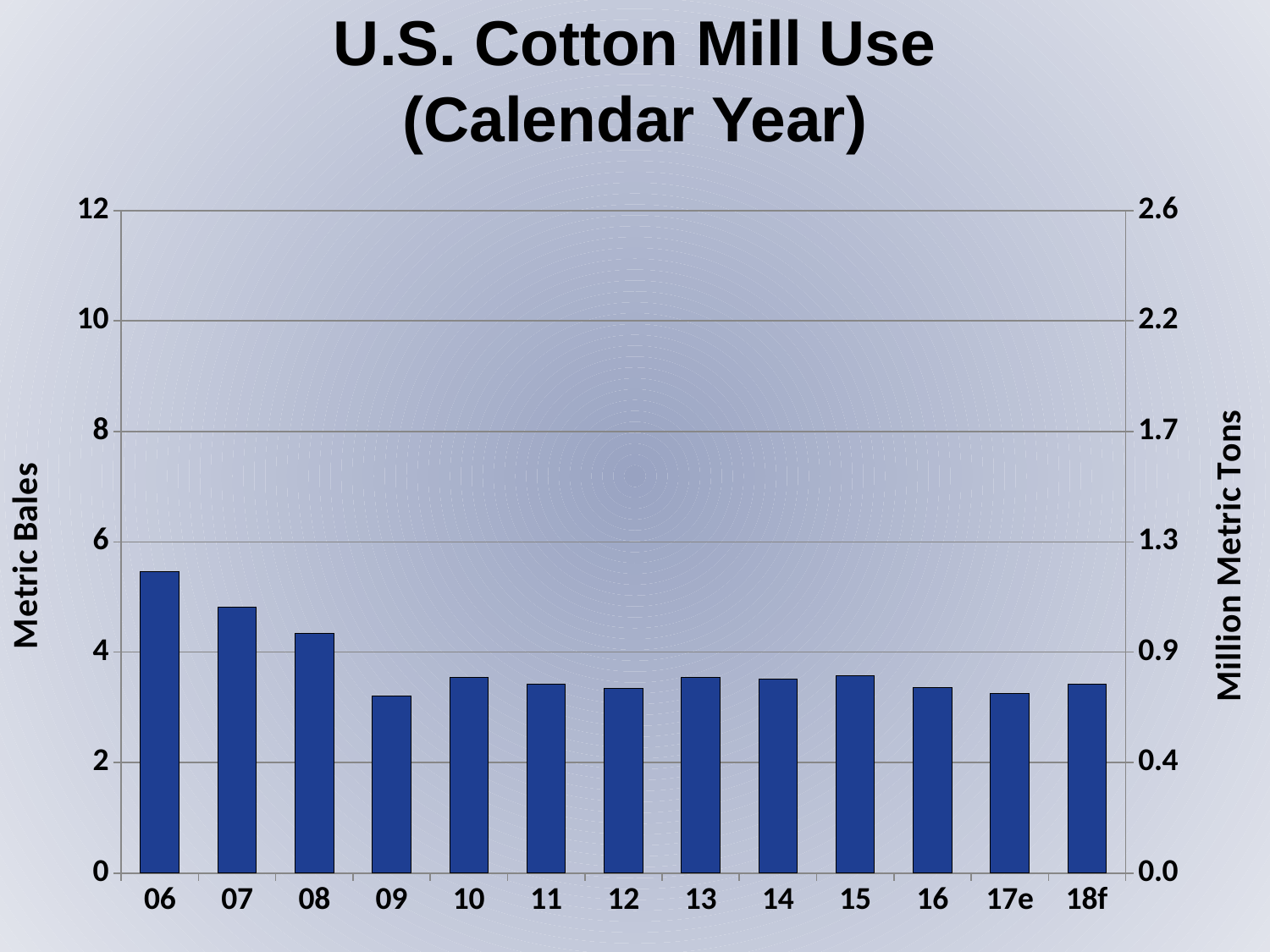
What is the title of the right vertical axis? Million Metric Tons Is the value for 06 greater or less than 4 metric bales? greater What kind of chart is shown on the slide? bar chart Is the value for 06 greater or less than 6 metric bales? less Which is larger, the value for 07 or the value for 08? 07 Which year has the highest cotton mill use? 06 Is the value for 10 greater or less than 4 metric bales? less Which is larger, the value for 08 or the value for 10? 08 How many years (categories) are shown on the x axis? 13 What is the title of the left vertical axis? Metric Bales Do the values rise or fall from 06 to 09? fall